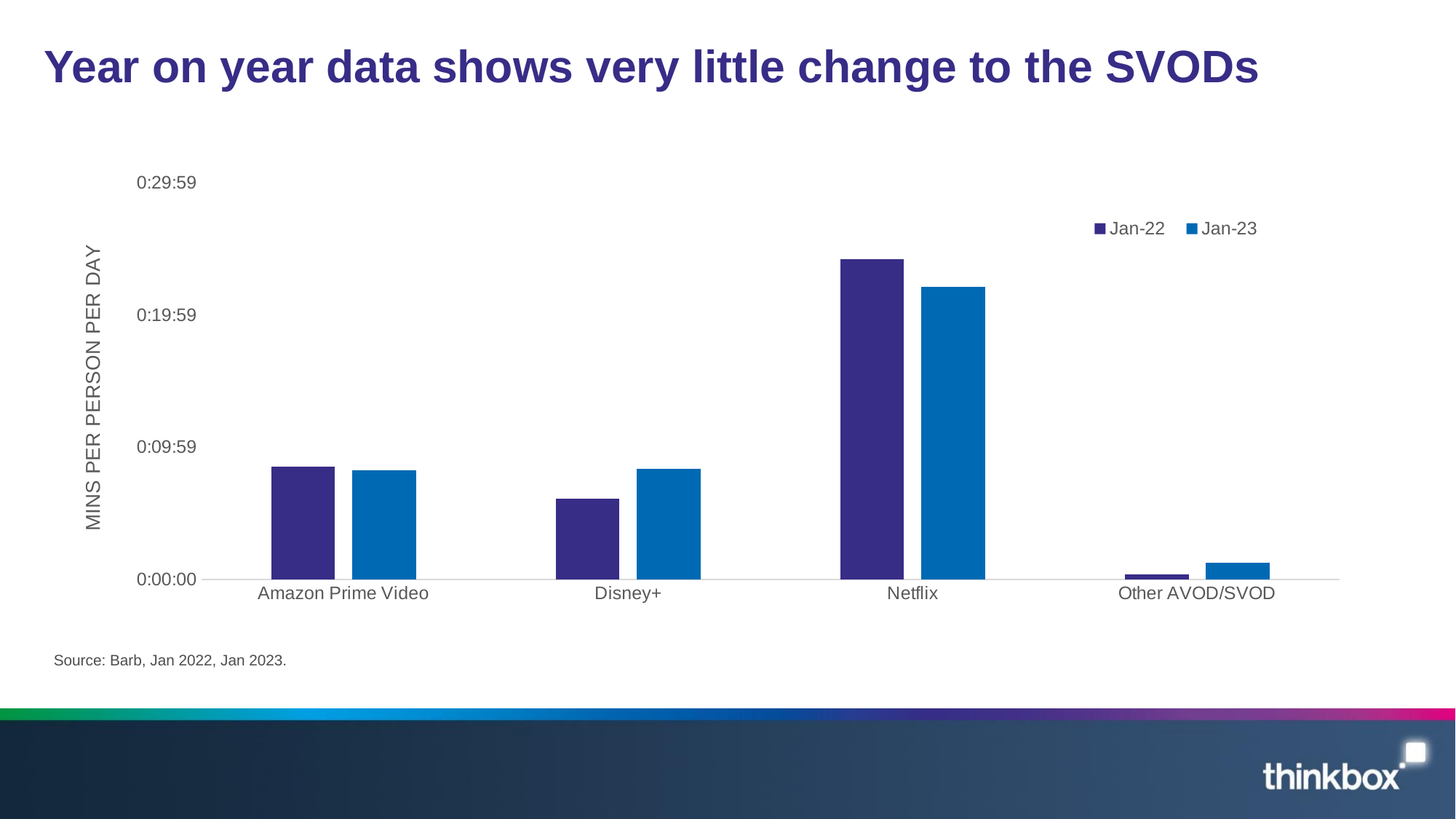
Is the Jan-23 value for Netflix greater or less than 0:19:59? greater How many series does the chart's legend list? 2 For Disney+, which is larger: the Jan-22 value or the Jan-23 value? Jan-23 Is the Jan-22 value for Netflix greater or less than 0:19:59? greater Is the Jan-22 value for Amazon Prime Video greater or less than 0:09:59? less Which category has the lowest value for Jan-23? Other AVOD/SVOD For Netflix, which is larger: the Jan-22 value or the Jan-23 value? Jan-22 How many categories are shown on the x axis of the chart? 4 What kind of chart is shown on the slide? Bar chart Which category has the highest value for Jan-22? Netflix What is the label on the chart's vertical axis? MINS PER PERSON PER DAY